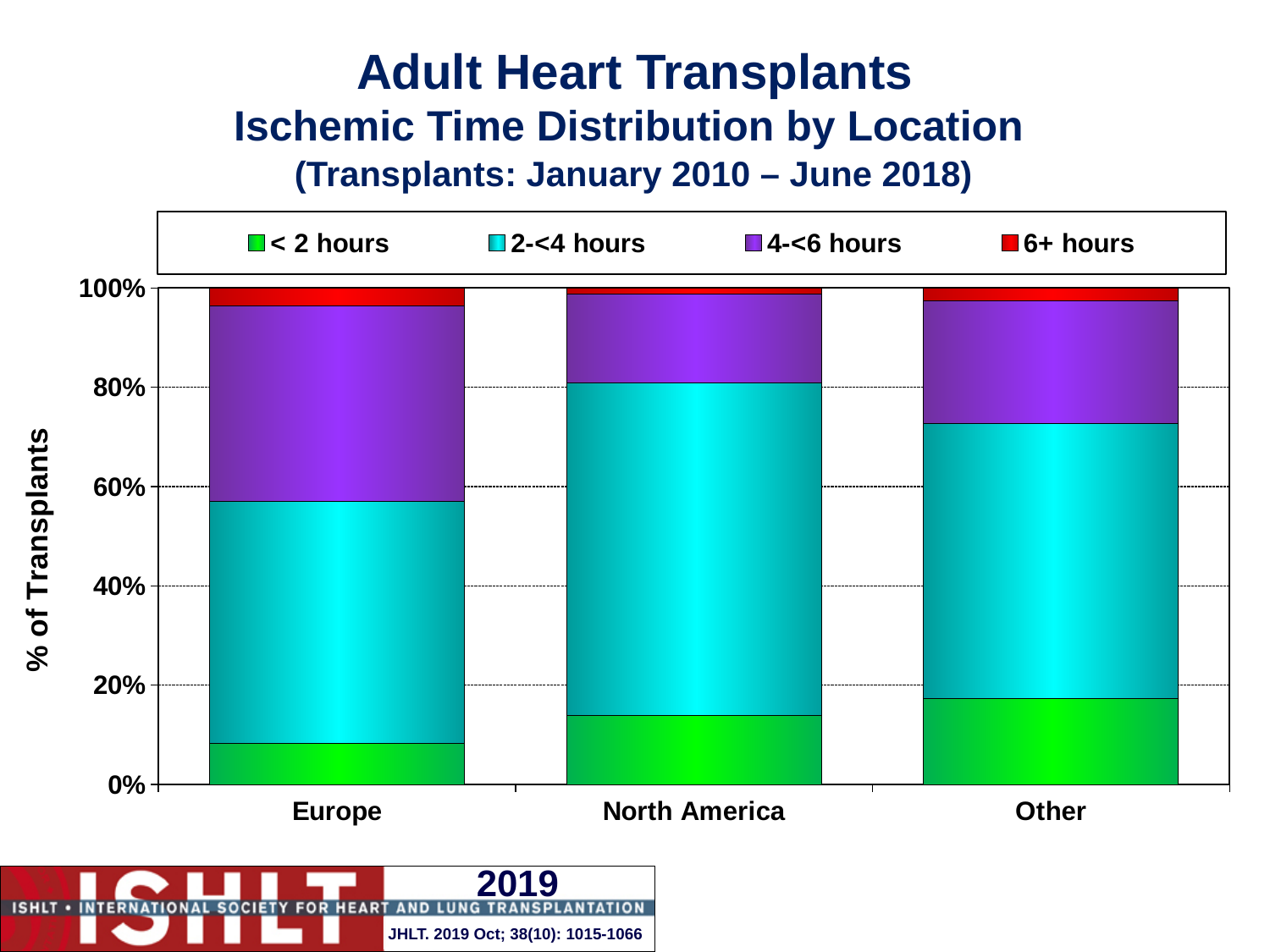
Which location has the smallest share of transplants with ischemic time 6+ hours? North America Is the share of transplants with ischemic time 4-<6 hours in Europe greater or less than 20%? greater Is the share of transplants with ischemic time < 2 hours in Europe greater or less than 20%? less What kind of chart is shown on the slide? Stacked bar chart Which location has the largest share of transplants with ischemic time 4-<6 hours? Europe How many locations are shown on the x axis? 3 Is the share of transplants with ischemic time < 2 hours larger in Europe or in Other? Other Which legend entry is shown in red? 6+ hours What is the label of the y axis? % of Transplants How many ischemic time categories does the legend list? 4 Is the share of transplants with ischemic time 2-<4 hours in North America greater or less than 60%? greater What is the total height of the North America stacked bar? 100%